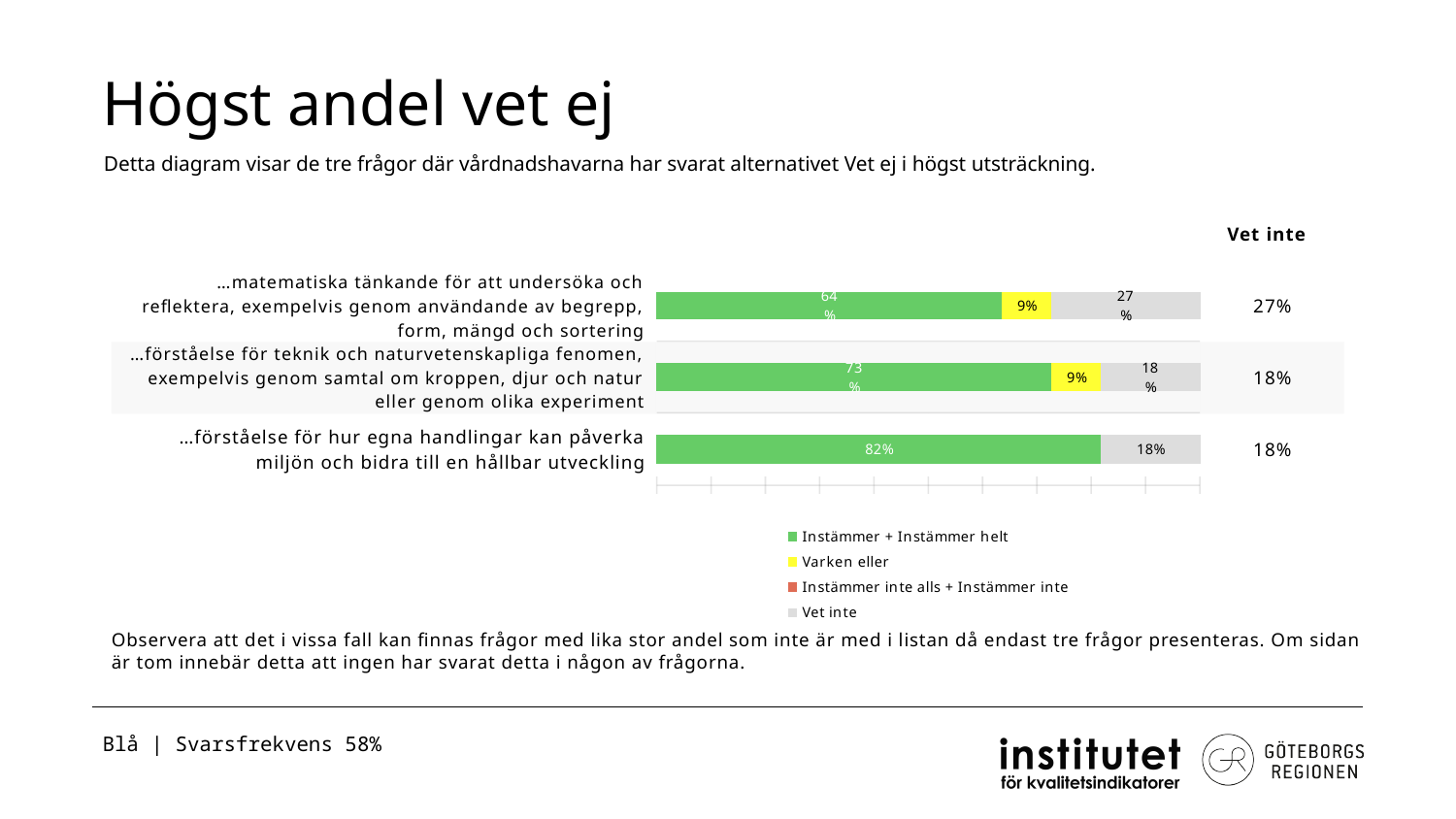
What kind of chart is shown on the slide? stacked bar chart What is the 'Instämmer + Instämmer helt' value for '…förståelse för teknik och naturvetenskapliga fenomen, exempelvis genom samtal om kroppen, djur och natur eller genom olika experiment'? 73% Which is larger: the 'Vet inte' value for '…matematiska tänkande…' or for '…förståelse för teknik och naturvetenskapliga fenomen…'? …matematiska tänkande… What is the difference between the 'Instämmer + Instämmer helt' values for '…förståelse för hur egna handlingar kan påverka miljön…' and '…matematiska tänkande…'? 18% Which category has the highest 'Vet inte' share? …matematiska tänkande för att undersöka och reflektera, exempelvis genom användande av begrepp, form, mängd och sortering Which category has the lowest 'Instämmer + Instämmer helt' share? …matematiska tänkande för att undersöka och reflektera, exempelvis genom användande av begrepp, form, mängd och sortering What is the 'Varken eller' value for '…förståelse för teknik och naturvetenskapliga fenomen…'? 9% What is the 'Vet inte' value for '…matematiska tänkande för att undersöka och reflektera, exempelvis genom användande av begrepp, form, mängd och sortering'? 27% Which legend entry is shown in grey? Vet inte What is the 'Instämmer + Instämmer helt' value for '…förståelse för hur egna handlingar kan påverka miljön och bidra till en hållbar utveckling'? 82% How many series does the legend list? 4 How many categories (questions) are plotted in the chart? 3